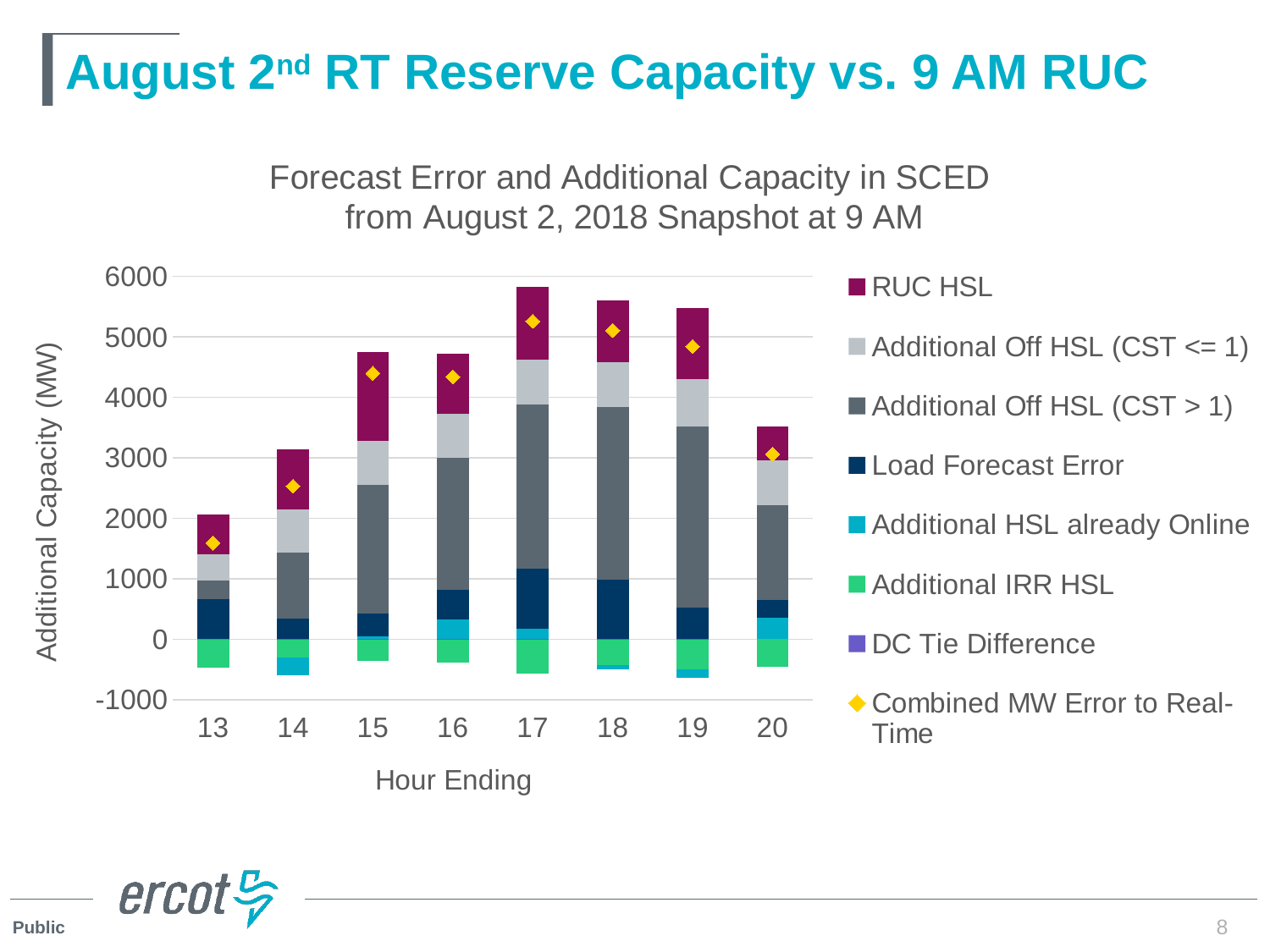
Does the Combined MW Error to Real-Time marker rise or fall from hour ending 13 to hour ending 17? rise Which stacked bar reaches higher, hour ending 15 or hour ending 14? 15 How many hour-ending categories are shown on the x axis? 8 Is the Combined MW Error to Real-Time value for hour ending 19 greater or less than 5000? less Which hour ending has the lowest Combined MW Error to Real-Time marker? 13 What kind of chart is shown on the slide? bar chart How many series does the legend list? 8 Is the Combined MW Error to Real-Time value for hour ending 17 greater or less than 5000? greater Which hour ending has the shortest stacked bar overall? 13 Is the Combined MW Error to Real-Time value for hour ending 13 greater or less than 2000? less What is the label on the x axis of the chart? Hour Ending